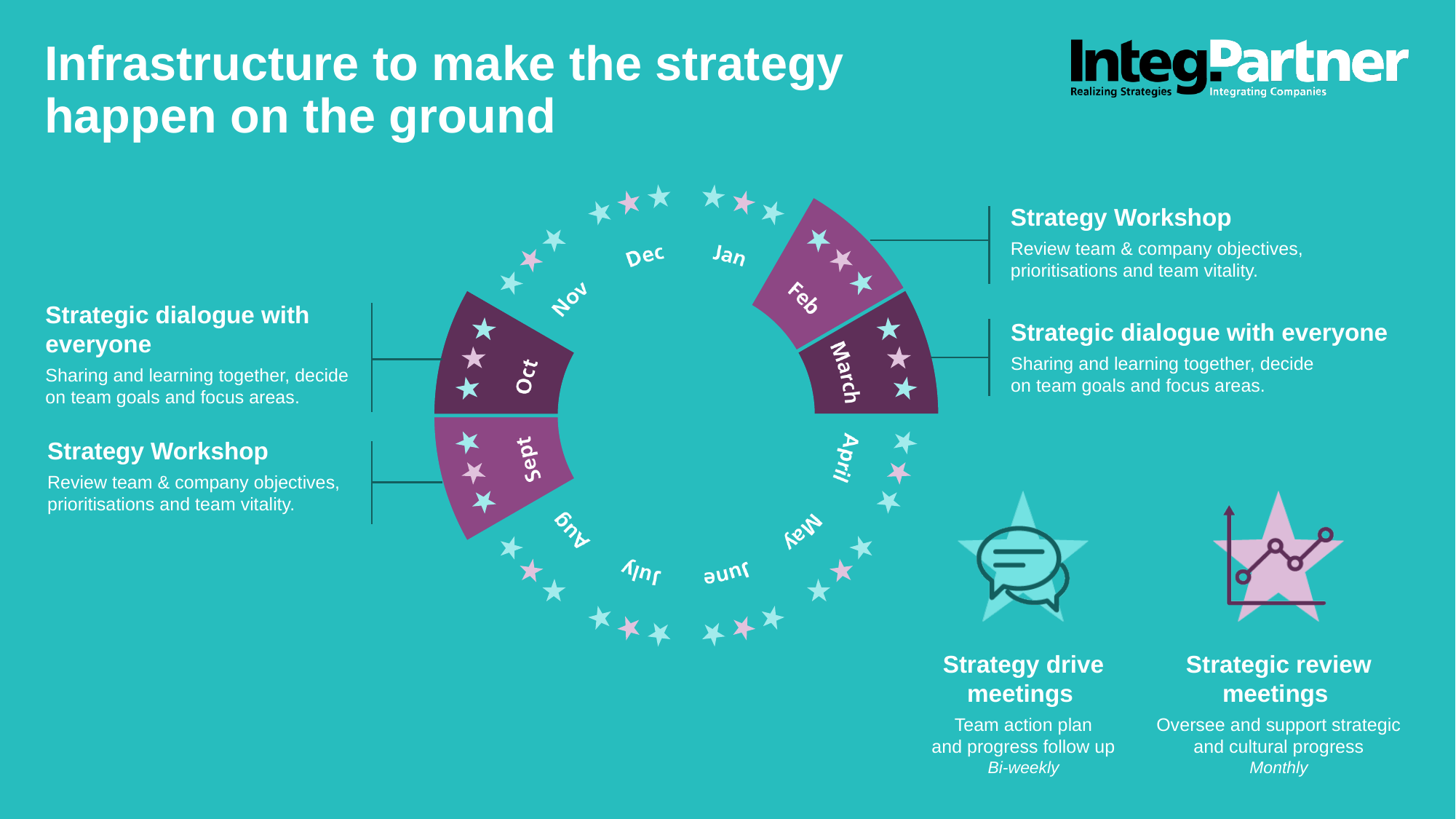
Which months are highlighted with coloured segments in the circular diagram? Feb, March, Sept, Oct What is the title of the slide containing the circular calendar diagram? Infrastructure to make the strategy happen on the ground How many stars are shown inside each highlighted month segment of the circular diagram? 3 Which activity is linked to the Sept segment of the circular diagram? Strategy Workshop Which activity is linked to the Oct segment of the circular diagram? Strategic dialogue with everyone How many months in the circular diagram are highlighted with a coloured segment? 4 Which activity is linked to the March segment of the circular diagram? Strategic dialogue with everyone Which activity is linked to the Feb segment of the circular diagram? Strategy Workshop In the circular diagram, are the Strategy Workshop segments (Feb and Sept) shown in a lighter or darker purple than the Strategic dialogue segments (March and Oct)? lighter Which month label appears at the top of the circular diagram immediately to the right of Dec? Jan How many month segments are shown around the circular calendar diagram? 12